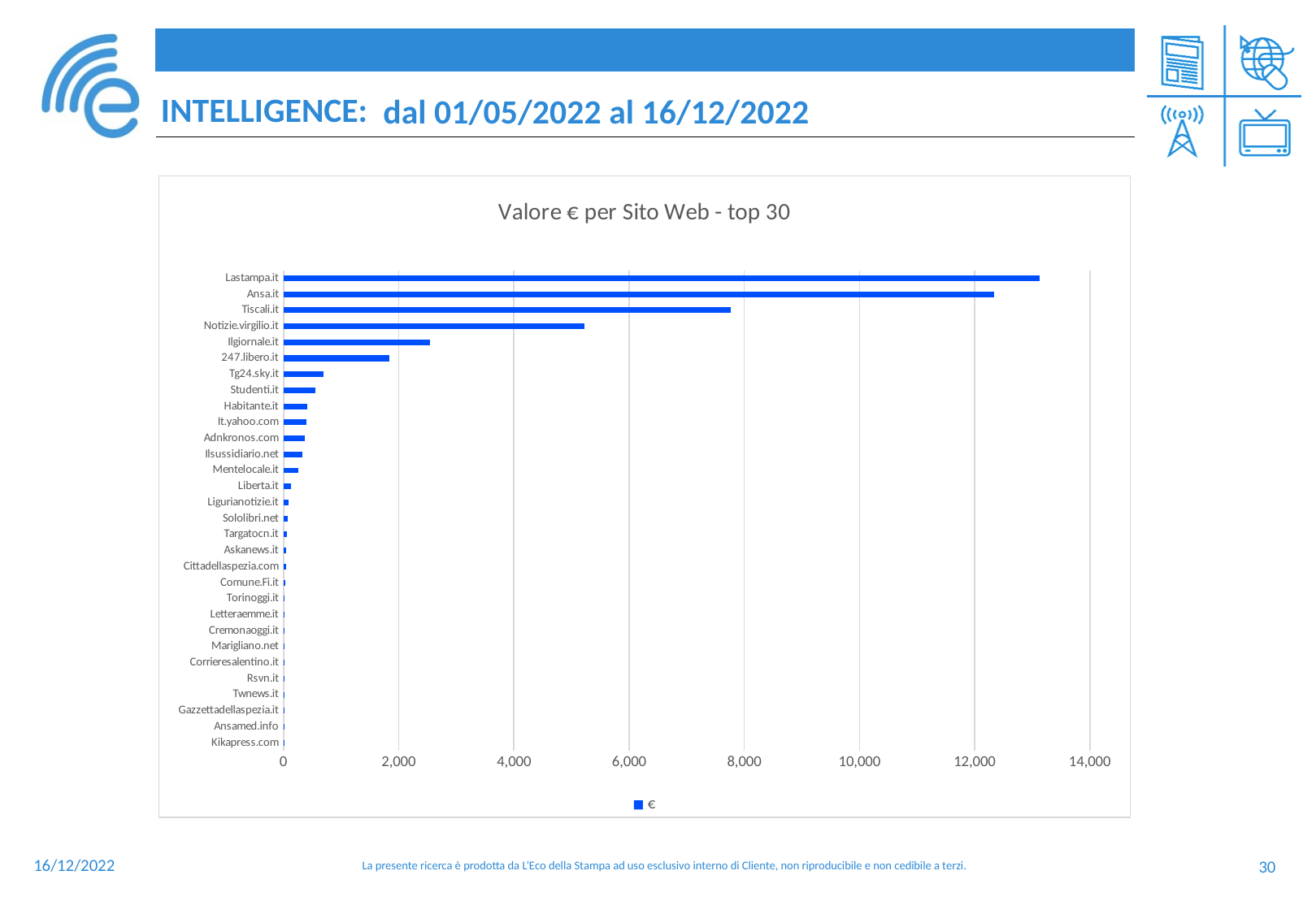
Is the value for 247.libero.it greater or less than 2,000? less How many categories (websites) are plotted in the chart? 30 Which website has the highest value in the chart? Lastampa.it Is the value for Tiscali.it greater or less than 8,000? less How many series does the legend list? 1 What kind of chart is shown on the slide? bar chart Is the value for Lastampa.it greater or less than 12,000? greater What is the title of the chart? Valore € per Sito Web - top 30 What is the legend entry shown below the chart? € Which has the larger value, Tiscali.it or Notizie.virgilio.it? Tiscali.it